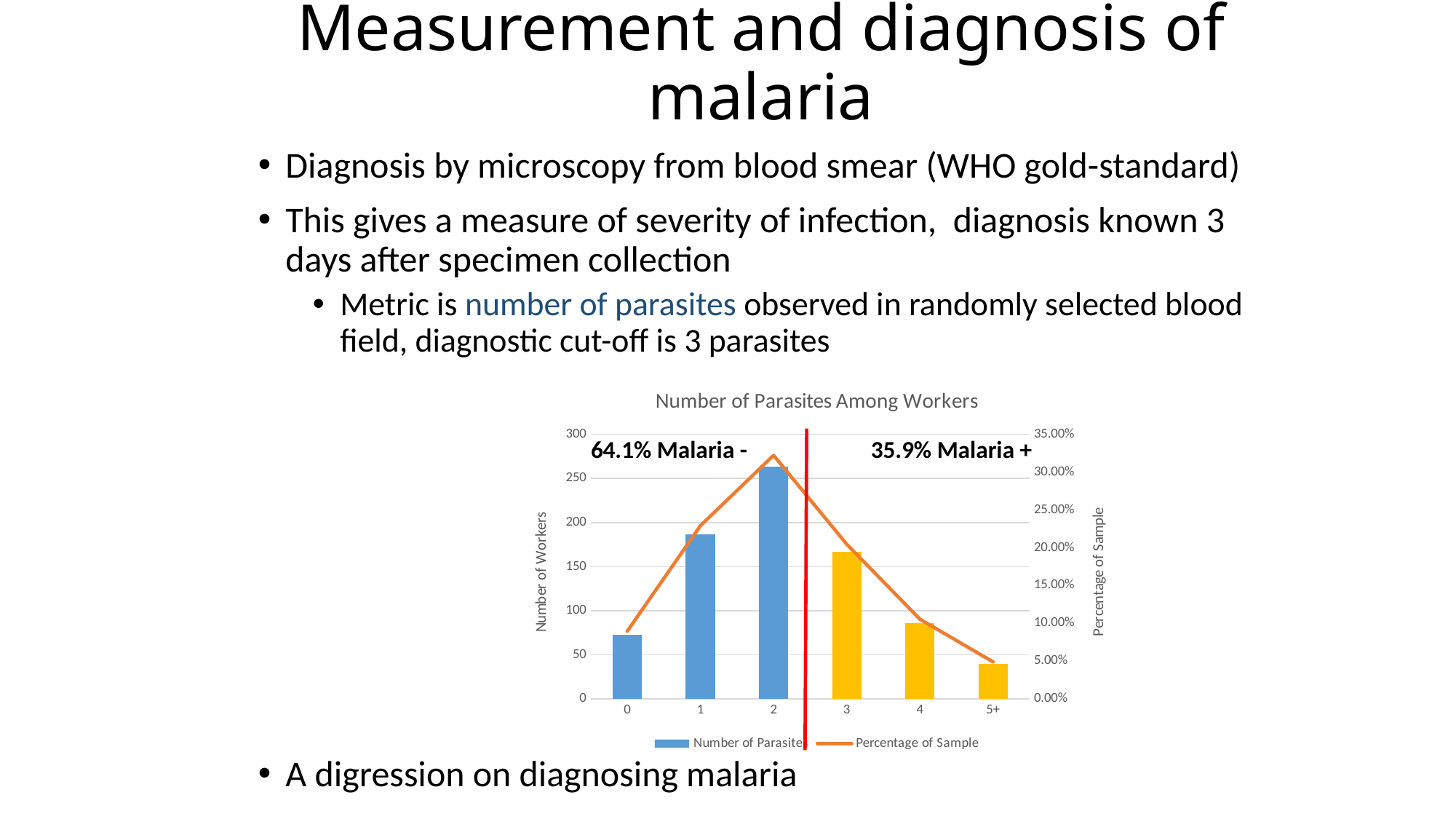
Is the number of workers with 3 parasites greater or less than 150? greater How many series does the chart legend list? 2 What is the title of the chart? Number of Parasites Among Workers Is the number of workers with 0 parasites greater or less than 100? less How many parasite-count categories are shown on the x axis of the chart? 6 Which parasite count has the highest number of workers? 2 What kind of chart is used to show the number of workers in the 'Number of Parasites Among Workers' chart? bar chart Which has more workers: 1 parasite or 4 parasites? 1 parasite Is the number of workers with 2 parasites greater or less than 250? greater Which parasite count has the lowest number of workers? 5+ What percentage of workers is labelled as Malaria negative on the chart? 64.1%